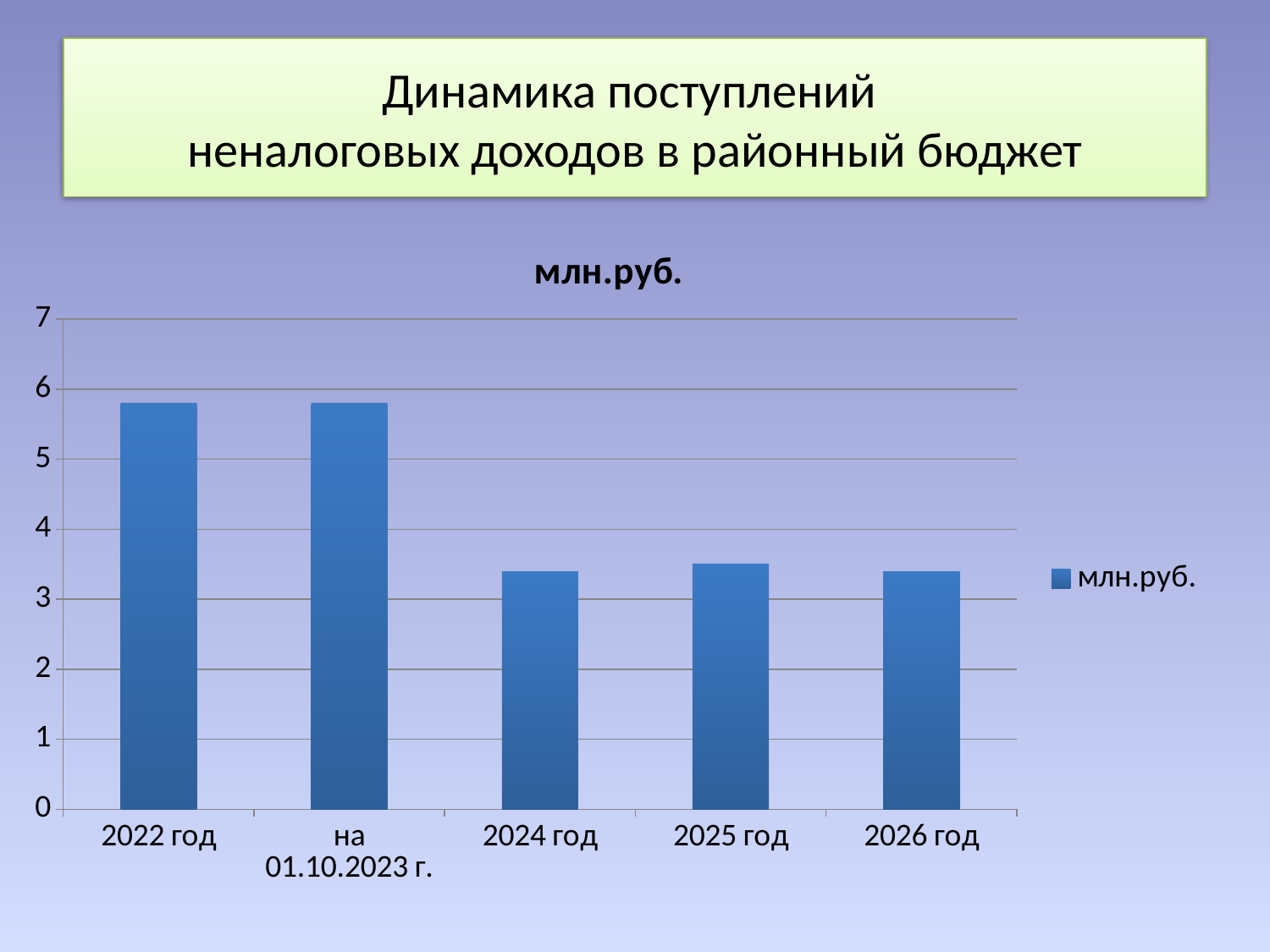
Is the value for 2024 год greater or less than 4? less Is the value for 2022 год greater or less than 5? greater How many series does the chart legend list? 1 Which is larger, the value for 2022 год or the value for 2024 год? 2022 год Is the value for на 01.10.2023 г. greater or less than 6? less How many categories are shown on the x axis of the chart? 5 Do the values generally rise or fall from 2022 год to 2026 год? fall What is the title of the chart? млн.руб. What kind of chart is shown on the slide? bar chart Which is larger, the value for 2026 год or the value for на 01.10.2023 г.? на 01.10.2023 г.